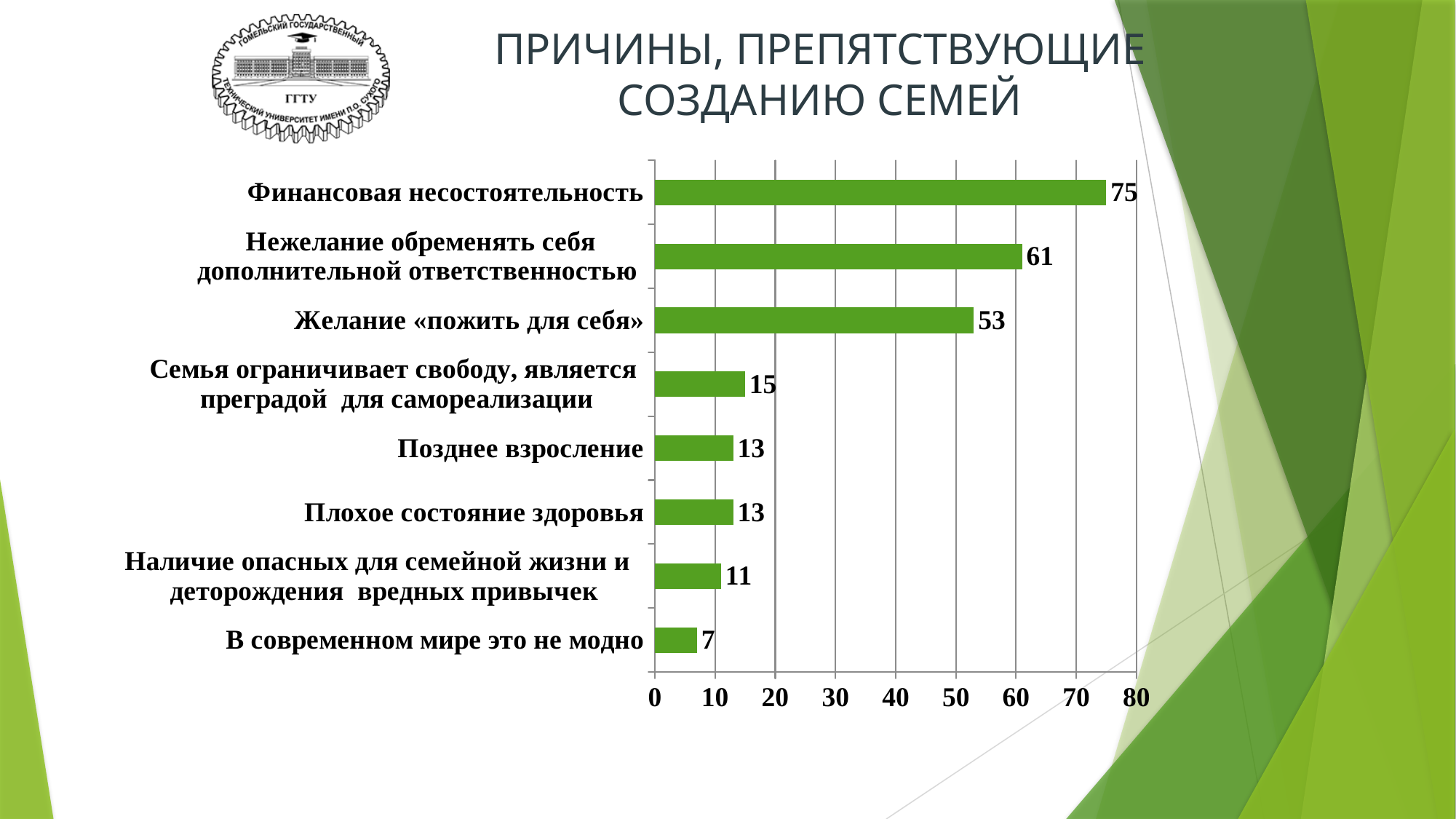
What is the difference between the values for «Финансовая несостоятельность» and «Нежелание обременять себя дополнительной ответственностью»? 14 Which category has the highest value? Финансовая несостоятельность Which is larger: the value for «Семья ограничивает свободу, является преградой для самореализации» or the value for «Наличие опасных для семейной жизни и деторождения вредных привычек»? Семья ограничивает свободу, является преградой для самореализации Which category has the lowest value? В современном мире это не модно What is the value for «В современном мире это не модно»? 7 What kind of chart is shown on the slide? bar chart How many categories are shown in the chart? 8 Is the value for «Нежелание обременять себя дополнительной ответственностью» greater or less than 50? greater What is the value for «Желание «пожить для себя»»? 53 What is the title of the slide? ПРИЧИНЫ, ПРЕПЯТСТВУЮЩИЕ СОЗДАНИЮ СЕМЕЙ What is the value for «Финансовая несостоятельность»? 75 What is the value for «Позднее взросление»? 13